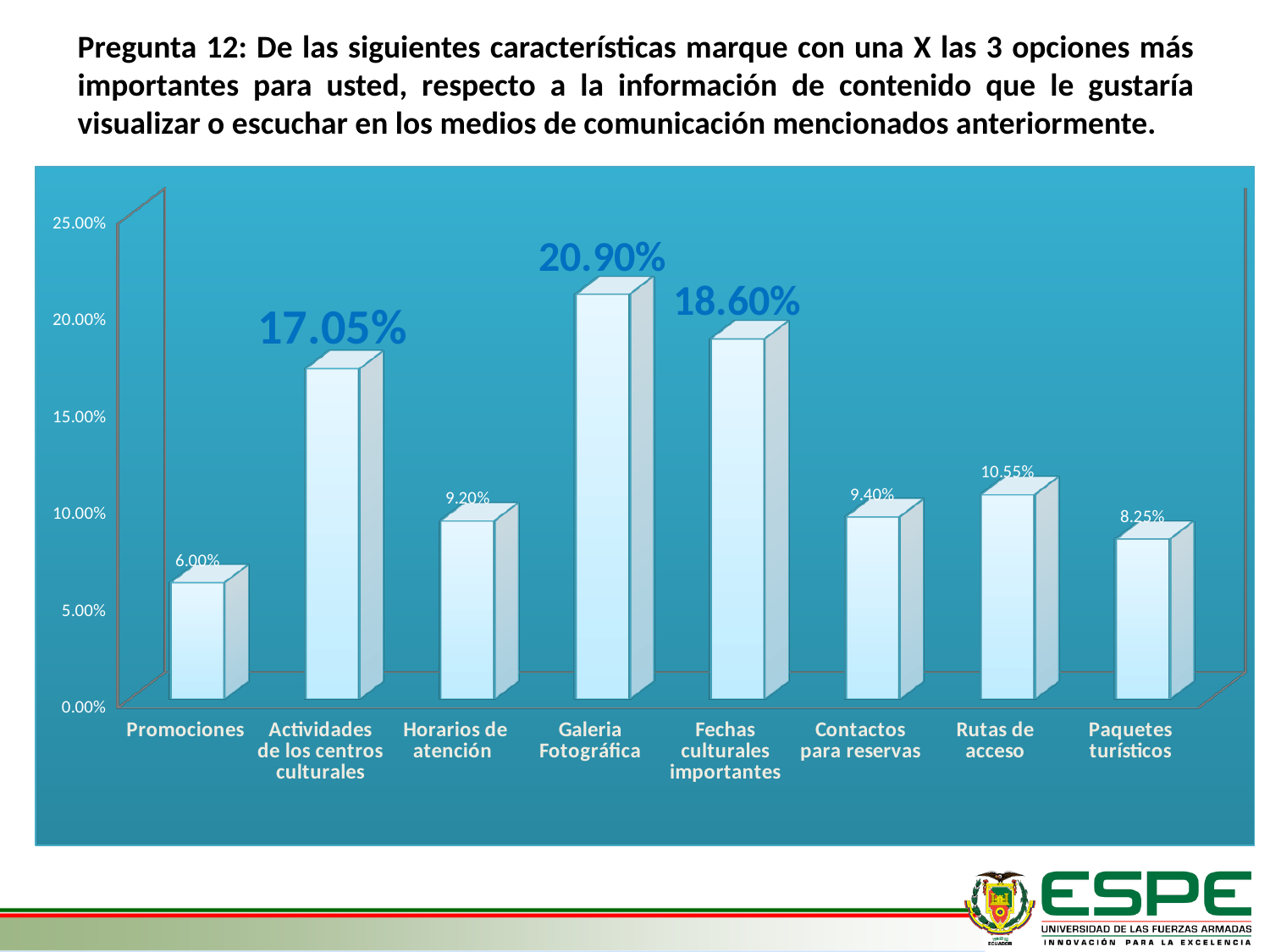
What is the value for Galeria Fotográfica? 20.90% Which category has the highest value? Galeria Fotográfica Which is larger, Horarios de atención or Contactos para reservas? Contactos para reservas What is the value for Rutas de acceso? 10.55% What kind of chart is shown on the slide? bar chart What is the value for Promociones? 6.00% What is the value for Paquetes turísticos? 8.25% What is the difference between Rutas de acceso and Paquetes turísticos? 2.30% How many categories are shown on the x axis? 8 Which category has the lowest value? Promociones What is the difference between Galeria Fotográfica and Fechas culturales importantes? 2.30% Is the value for Actividades de los centros culturales greater or less than 15.00%? greater